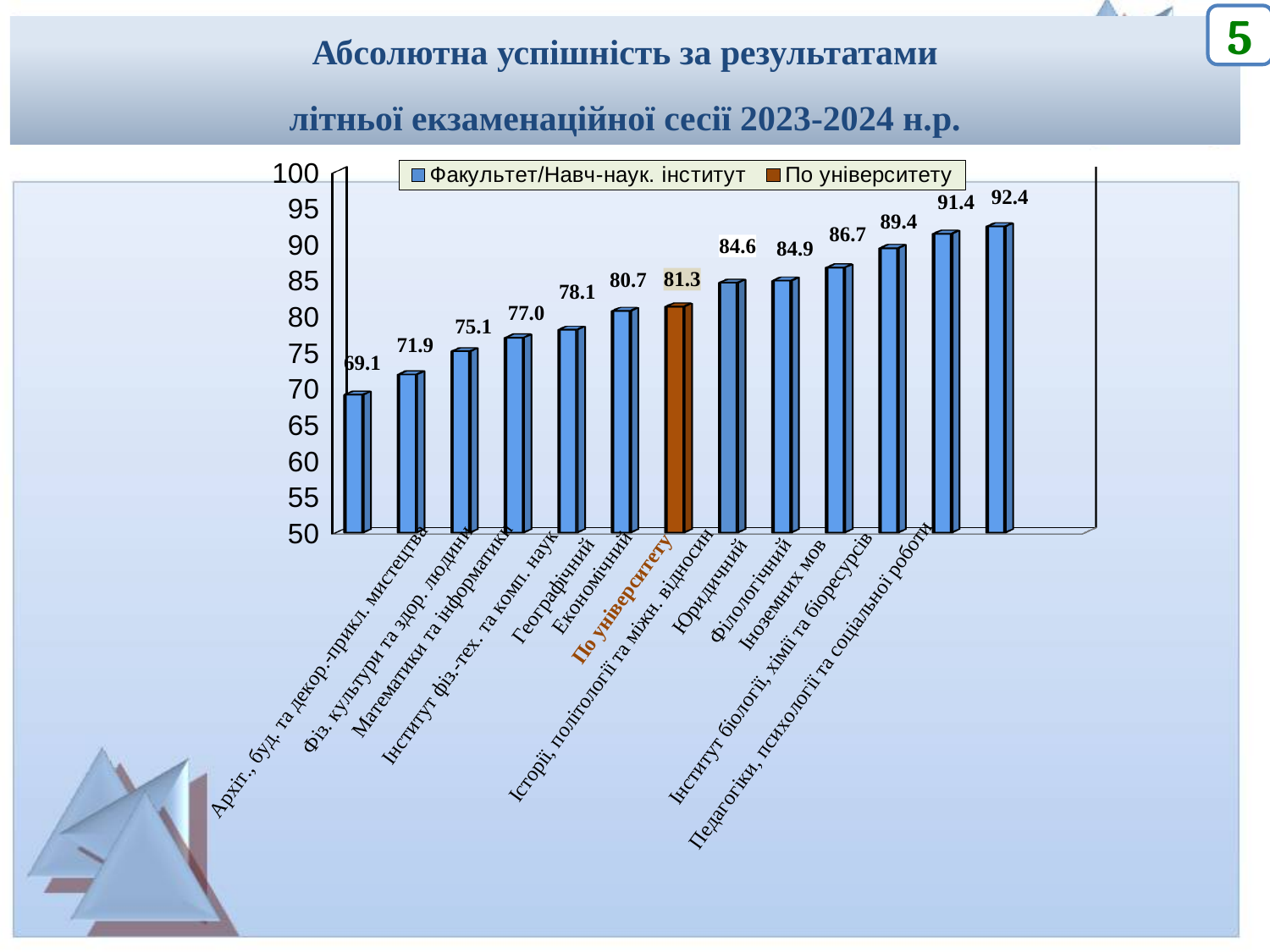
What is the difference between the values for Педагогіки, психології та соціальної роботи and Архіт., буд. та декор.-прикл. мистецтва? 23.3 What is the value for Іноземних мов? 89.4 Do the values rise or fall from left to right along the x axis? rise Which category has the highest value? Педагогіки, психології та соціальної роботи What kind of chart is shown on the slide? bar chart Is the value for Математики та інформатики greater or less than 80? less What is the value shown for По університету? 81.3 How many series does the legend list? 2 Which is larger, the value for Філологічний or the value for Географічний? Філологічний What is the value for Економічний? 80.7 Which category has the lowest value? Архіт., буд. та декор.-прикл. мистецтва How many bars are plotted in the chart? 13